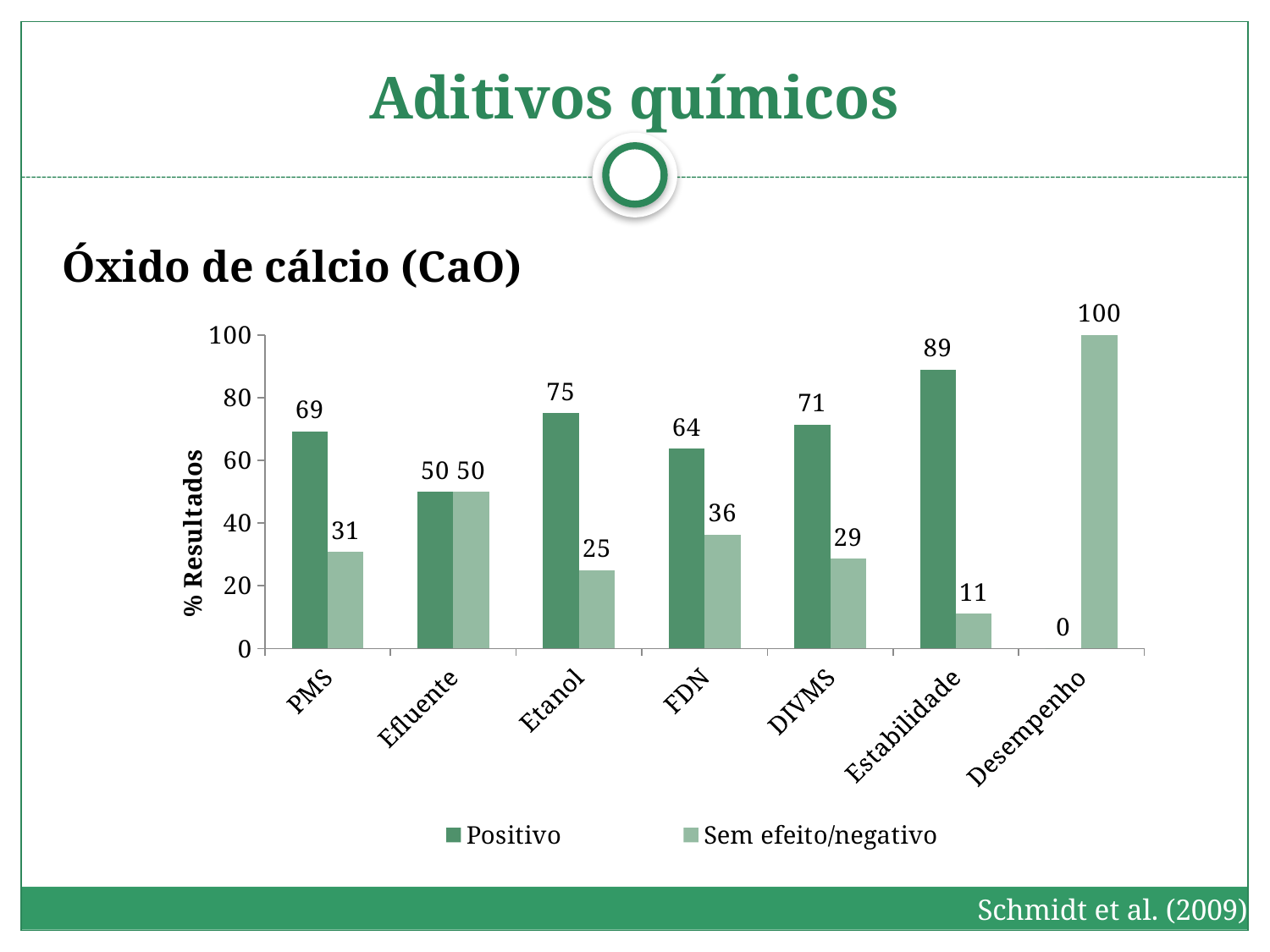
Which category has the highest Positivo value? Estabilidade Which is larger, the Positivo value for Etanol or the Positivo value for DIVMS? Etanol What is the Sem efeito/negativo value for FDN? 36 What is the Positivo value for Estabilidade? 89 How many categories are shown on the x axis? 7 What is the y-axis label of the chart? % Resultados What is the difference between the Positivo and Sem efeito/negativo values for PMS? 38 What is the Positivo value for Desempenho? 0 What kind of chart is shown on the slide? bar chart How many series does the legend list? 2 What is the Sem efeito/negativo value for Desempenho? 100 Which category has the lowest Sem efeito/negativo value? Estabilidade